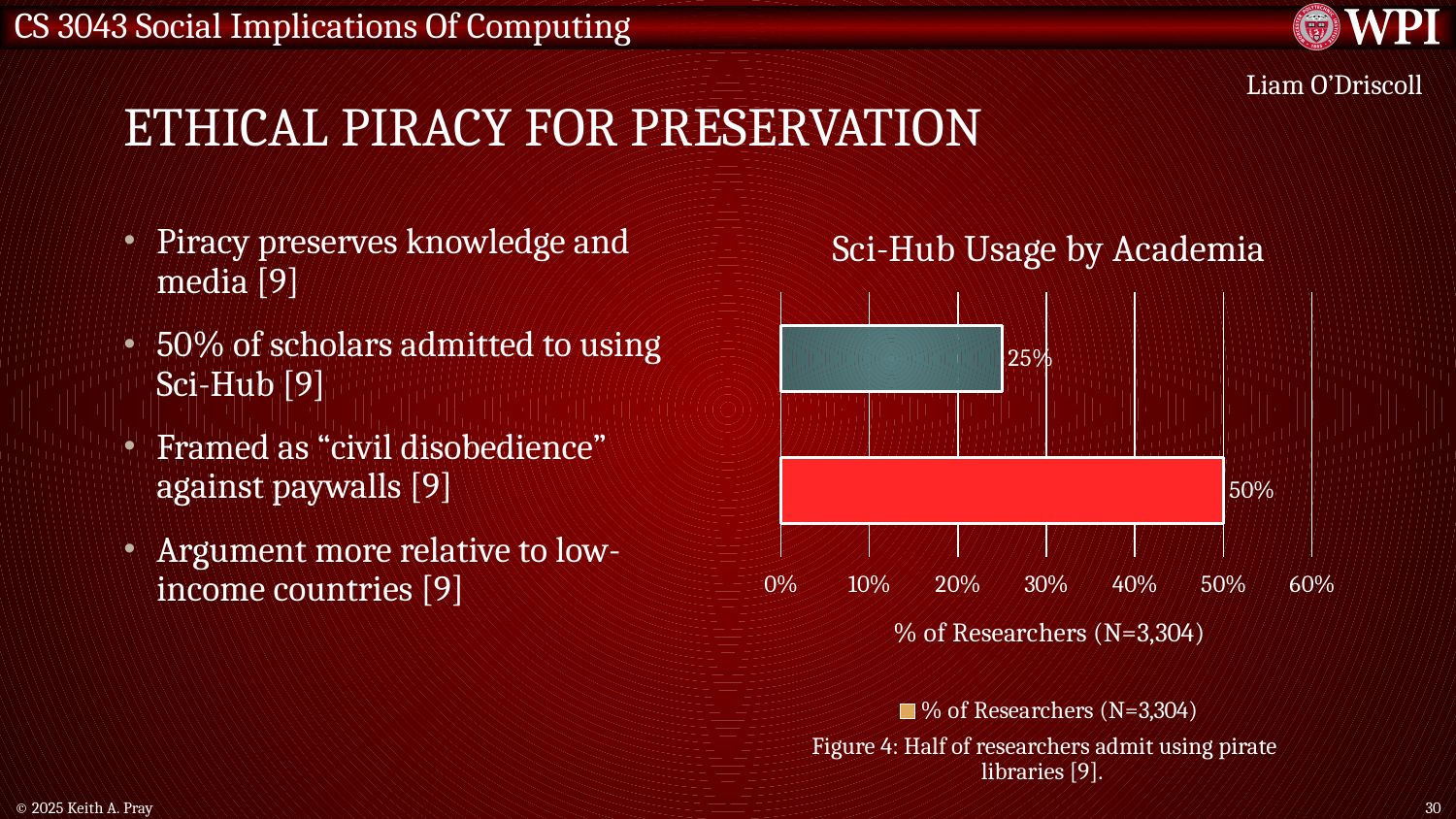
Which bar has the lower value, the top bar or the bottom bar? the top bar What is the label on the chart's horizontal axis? % of Researchers (N=3,304) Is the value of the top bar greater or less than 30%? less How many bars are plotted in the chart? 2 Which bar has the higher value, the top bar or the bottom bar? the bottom bar What value is labelled on the top (teal) bar of the chart? 25% What value is labelled on the bottom (red) bar of the chart? 50% What is the difference between the bottom bar's value and the top bar's value? 25% How many series does the chart's legend list? 1 What kind of chart is shown on the slide? bar chart Is the value of the red bar larger or smaller than the value of the teal bar? larger What is the title of the chart? Sci-Hub Usage by Academia